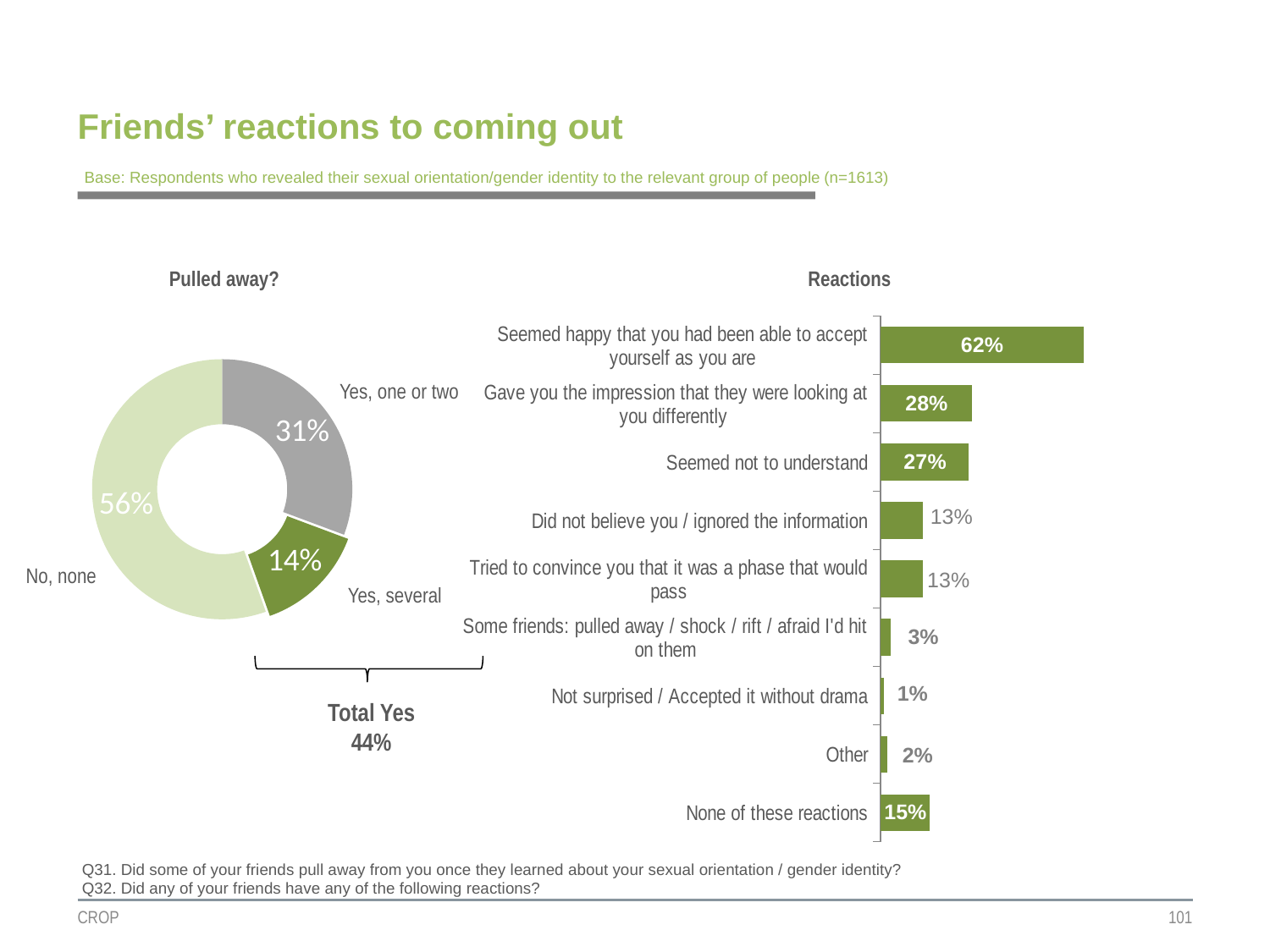
What kind of chart is the 'Reactions' chart? Bar chart In the 'Reactions' chart, what is the value for 'None of these reactions'? 15% What kind of chart is the 'Pulled away?' chart? Doughnut chart In the 'Pulled away?' chart, what percentage of respondents answered 'No, none'? 56% In the 'Reactions' chart, what is the value for 'Seemed happy that you had been able to accept yourself as you are'? 62% In the 'Pulled away?' chart, how many slices does the doughnut have? 3 In the 'Reactions' chart, how many reaction categories are listed? 9 In the 'Reactions' chart, which reaction has the lowest value? Not surprised / Accepted it without drama In the 'Pulled away?' chart, what is the 'Total Yes' percentage shown below the chart? 44% In the 'Pulled away?' chart, which category has the largest share? No, none In the 'Pulled away?' chart, what percentage answered 'Yes, several'? 14% In the 'Reactions' chart, what is the difference between 'Gave you the impression that they were looking at you differently' and 'Seemed not to understand'? 1%